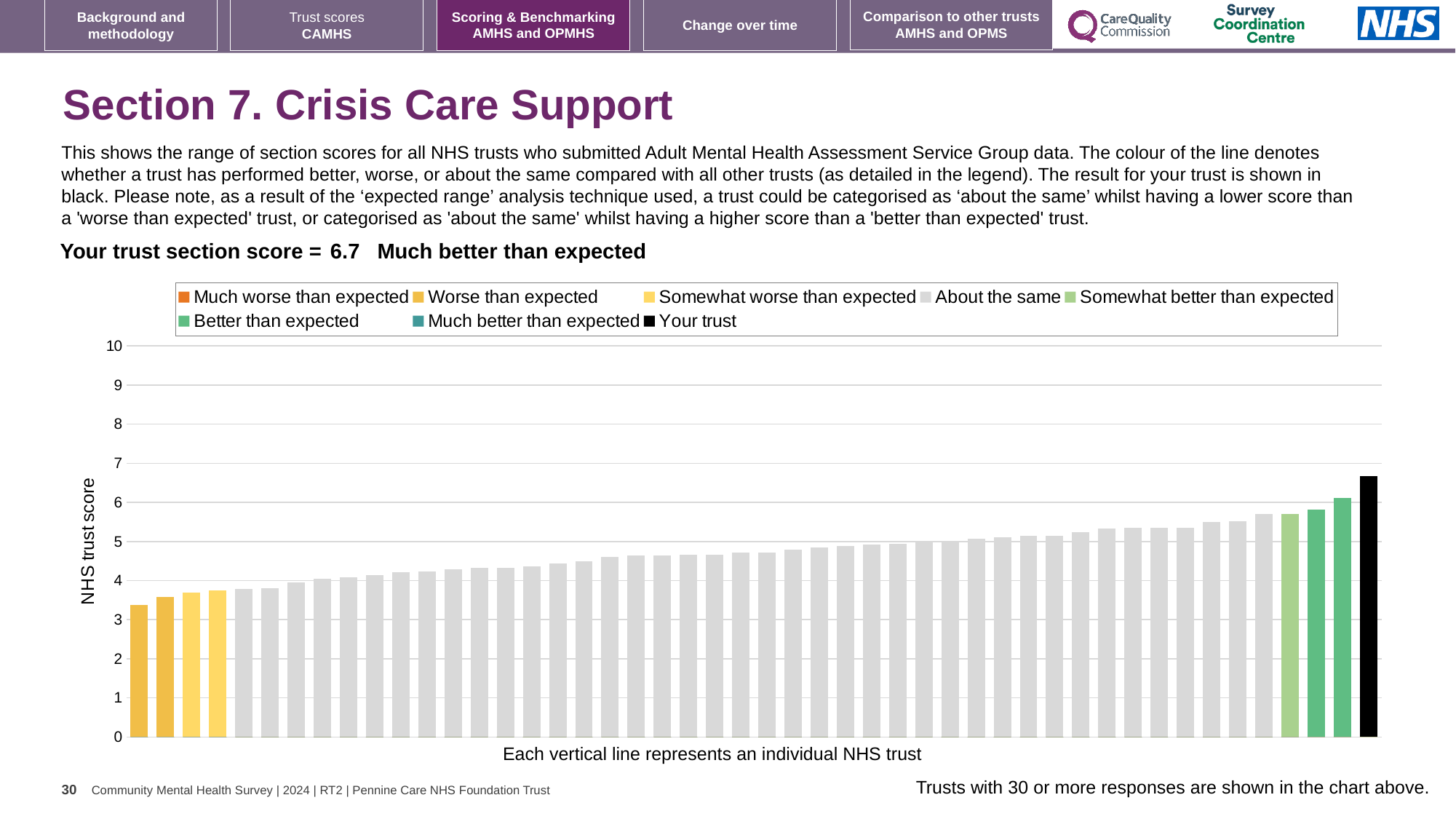
Is the value of the tallest grey (About the same) bar greater or less than 6? less Is the value of the lowest bar in the chart greater or less than 3? greater What colour is the bar representing your trust? black Is the value of the lowest bar in the chart greater or less than 4? less What is the label on the y axis of the chart? NHS trust score What kind of chart is shown on the slide? bar chart How many entries does the chart legend list? 8 Do the bar values rise or fall from left to right along the x axis? rise Which is larger: the value for your trust or the value of the tallest green (Better than expected) bar? Your trust Which bar in the chart is the highest? Your trust What is the section score for your trust shown on the slide? 6.7